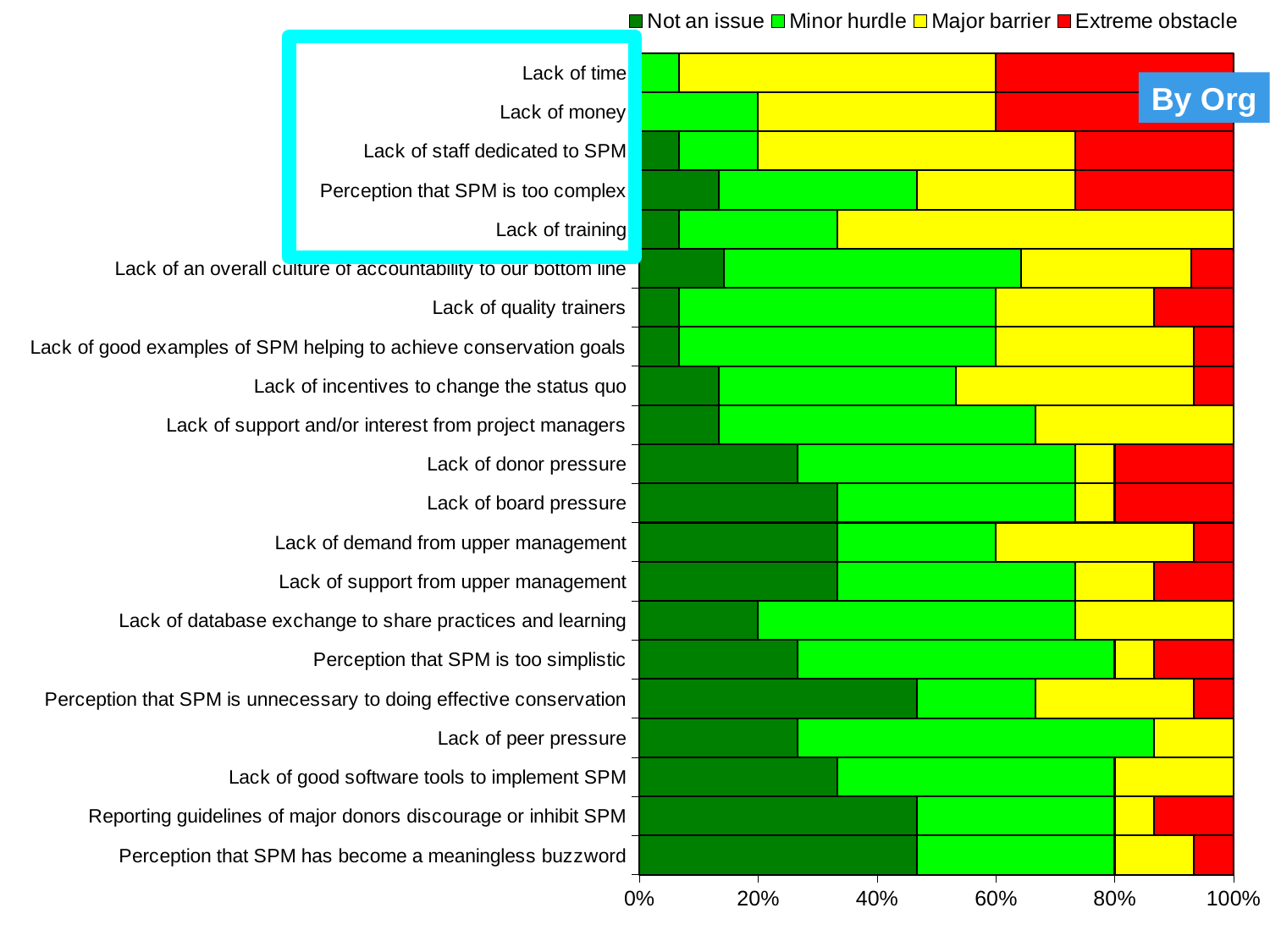
Is the 'Extreme obstacle' share for 'Lack of time' greater or less than 20%? greater Which has the larger 'Extreme obstacle' share: 'Lack of time' or 'Lack of peer pressure'? Lack of time Which has the larger 'Not an issue' share: 'Lack of time' or 'Perception that SPM has become a meaningless buzzword'? Perception that SPM has become a meaningless buzzword Is the 'Minor hurdle' share for 'Lack of peer pressure' greater or less than 40%? greater What kind of chart is shown on the slide? Stacked bar chart Is the 'Not an issue' share for 'Perception that SPM has become a meaningless buzzword' greater or less than 40%? greater Which colour represents 'Extreme obstacle' in the chart? Red What are the four response categories listed in the legend? Not an issue, Minor hurdle, Major barrier, Extreme obstacle How many series does the legend list? 4 How many categories (barriers) are plotted on the chart? 21